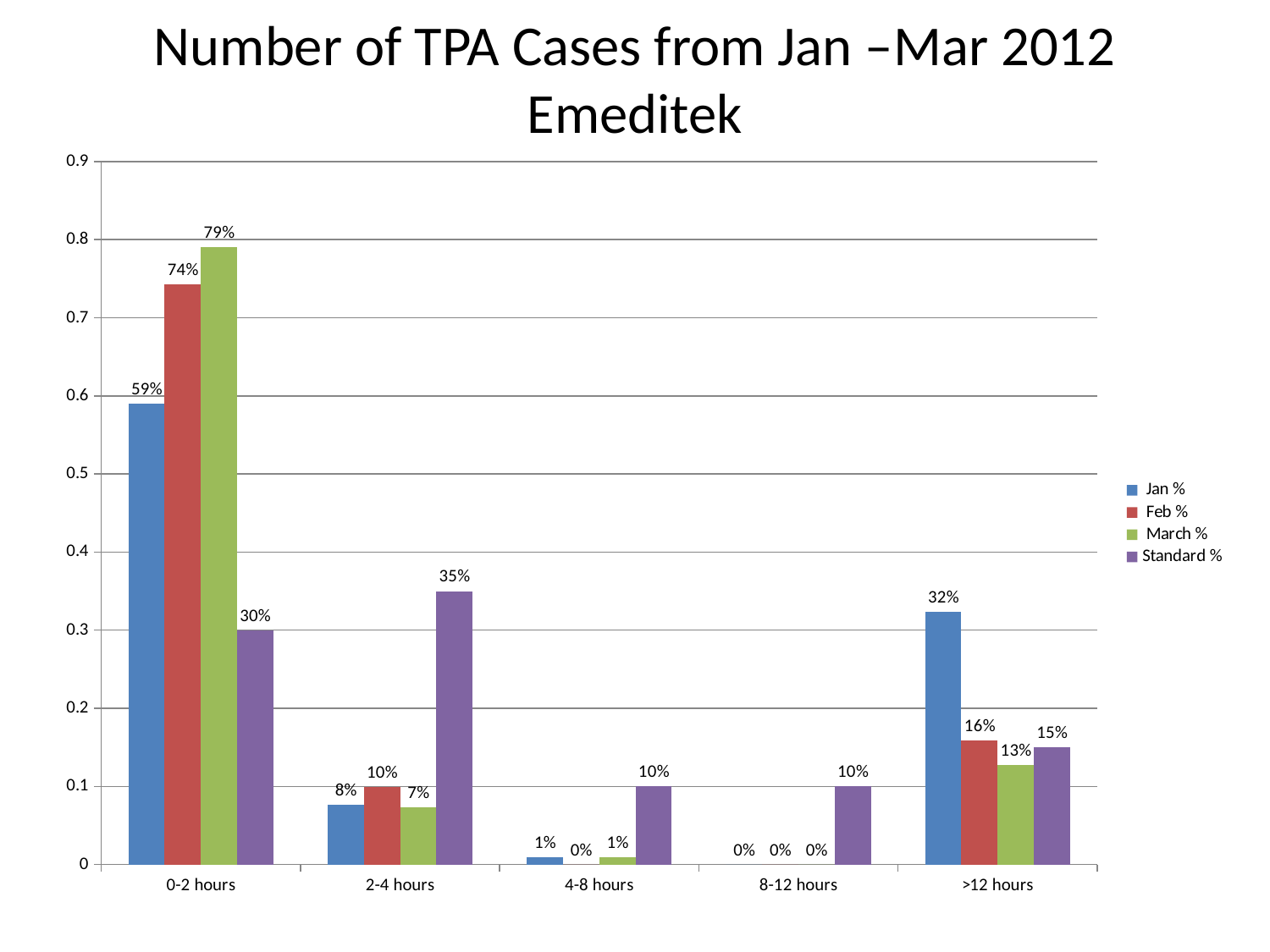
What is the difference between the March % and Jan % values for 0-2 hours? 20% Which series has the lowest value for >12 hours? March % How many series does the legend list? 4 What is the Standard % value for 2-4 hours? 35% How many time categories are shown on the x axis? 5 Is the Feb % value for 0-2 hours greater or less than 0.7? greater What is the Jan % value for 0-2 hours? 59% Which series has the highest value for 0-2 hours? March % What is the title of the chart? Number of TPA Cases from Jan –Mar 2012 Emeditek What kind of chart is shown on the slide? Bar chart Which is larger for >12 hours, Jan % or Standard %? Jan % What is the March % value for >12 hours? 13%